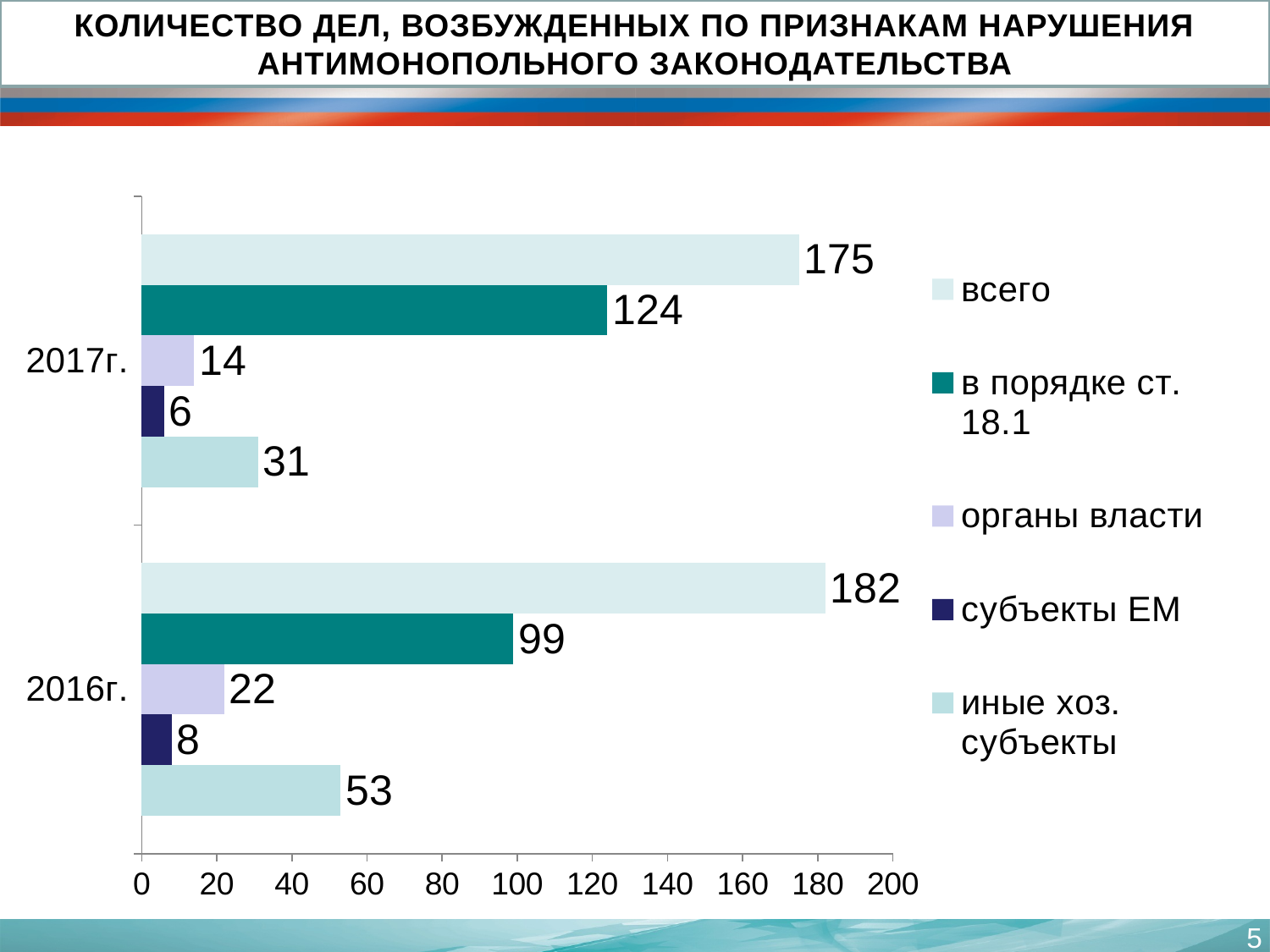
What is the value of "органы власти" for 2017г.? 14 What is the value of "в порядке ст. 18.1" for 2016г.? 99 Which series has the lowest value for 2016г.? субъекты ЕМ What is the maximum value shown on the horizontal axis? 200 What is the value of "всего" for 2017г.? 175 How many year categories are shown on the chart? 2 What is the difference between the "иные хоз. субъекты" values for 2016г. and 2017г.? 22 How many series does the legend list? 5 What is the value of "иные хоз. субъекты" for 2016г.? 53 What kind of chart is shown on the slide? bar chart What is the difference between the "в порядке ст. 18.1" values for 2017г. and 2016г.? 25 Which year has the higher value for "всего"? 2016г.